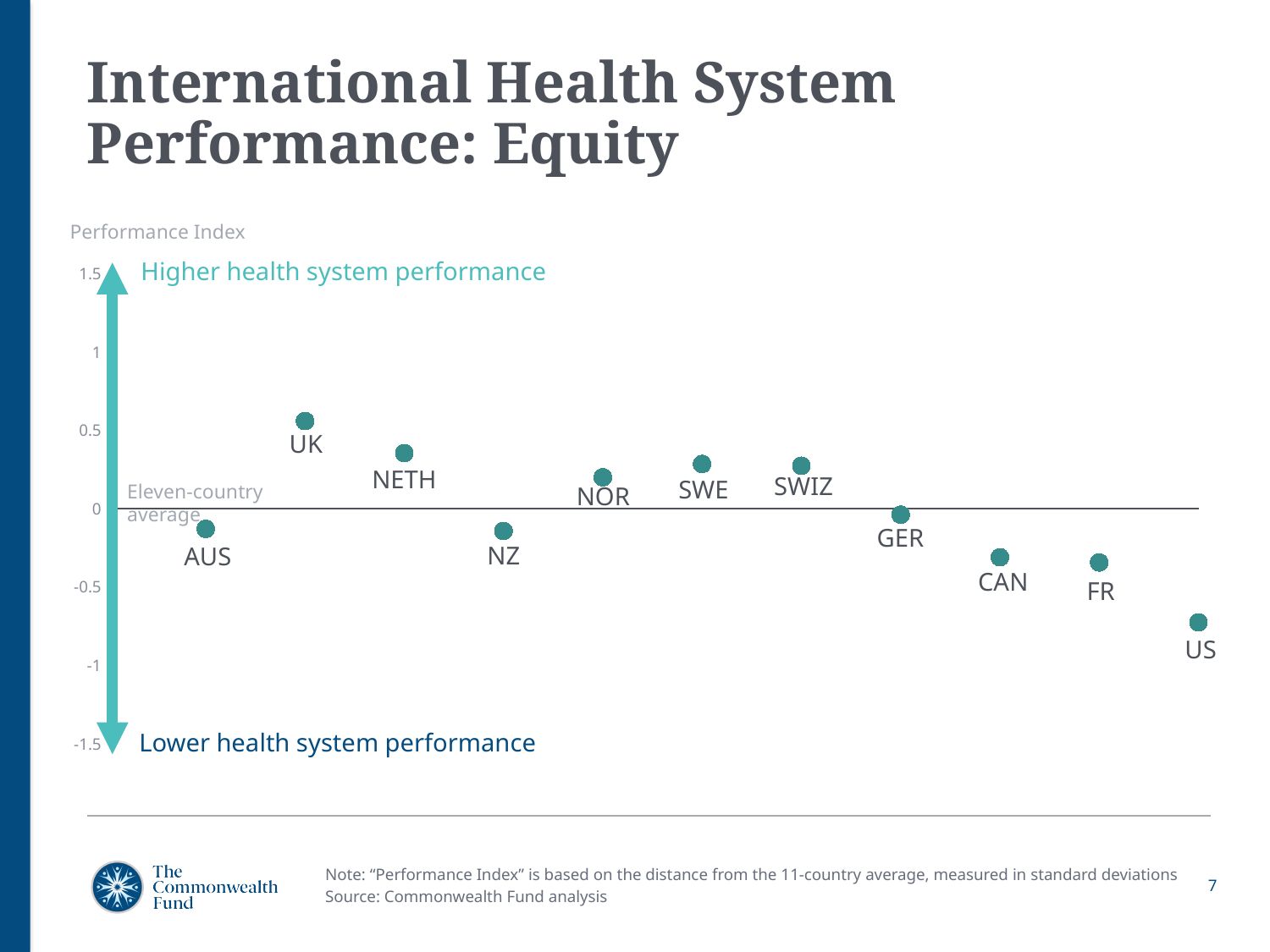
Is the Performance Index for AUS greater or less than 0? less Which has a higher Performance Index, UK or NETH? UK How many countries are plotted on the chart? 11 What is the label of the vertical axis on the chart? Performance Index Which country has the highest Performance Index on the chart? UK Which has a lower Performance Index, US or CAN? US Is the Performance Index for NETH greater or less than 0.5? less What kind of chart is shown on the slide? Scatter (dot) chart Is the Performance Index for US greater or less than -0.5? less Which country has the lowest Performance Index on the chart? US